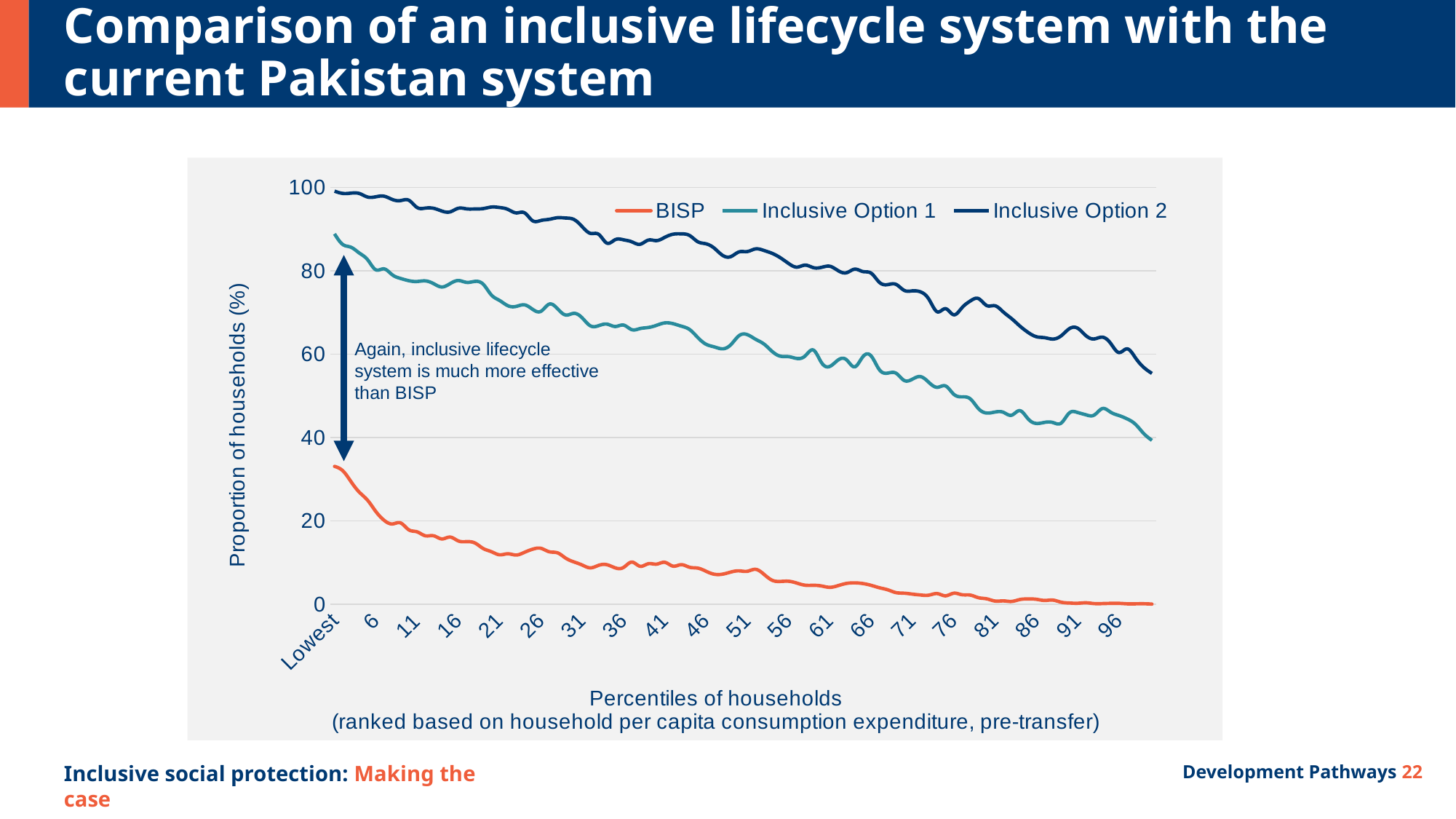
Is the value for BISP at percentile 51 greater or less than 20? less At the Lowest percentile, which is larger: the value for Inclusive Option 1 or the value for BISP? Inclusive Option 1 Is the value for Inclusive Option 2 at the Lowest percentile greater or less than 80? greater Do the values for Inclusive Option 2 rise or fall from the lowest percentile to the 96th? Fall What colour is the BISP line in the chart? Orange What kind of chart is shown on the slide? Line chart How many series does the chart's legend list? 3 Is the value for BISP at the Lowest percentile greater or less than 40? less Which series is plotted highest across all percentiles? Inclusive Option 2 What is the label of the chart's y axis? Proportion of households (%) Do the values for BISP rise or fall as the percentile increases along the x axis? Fall Which series is plotted lowest across all percentiles? BISP